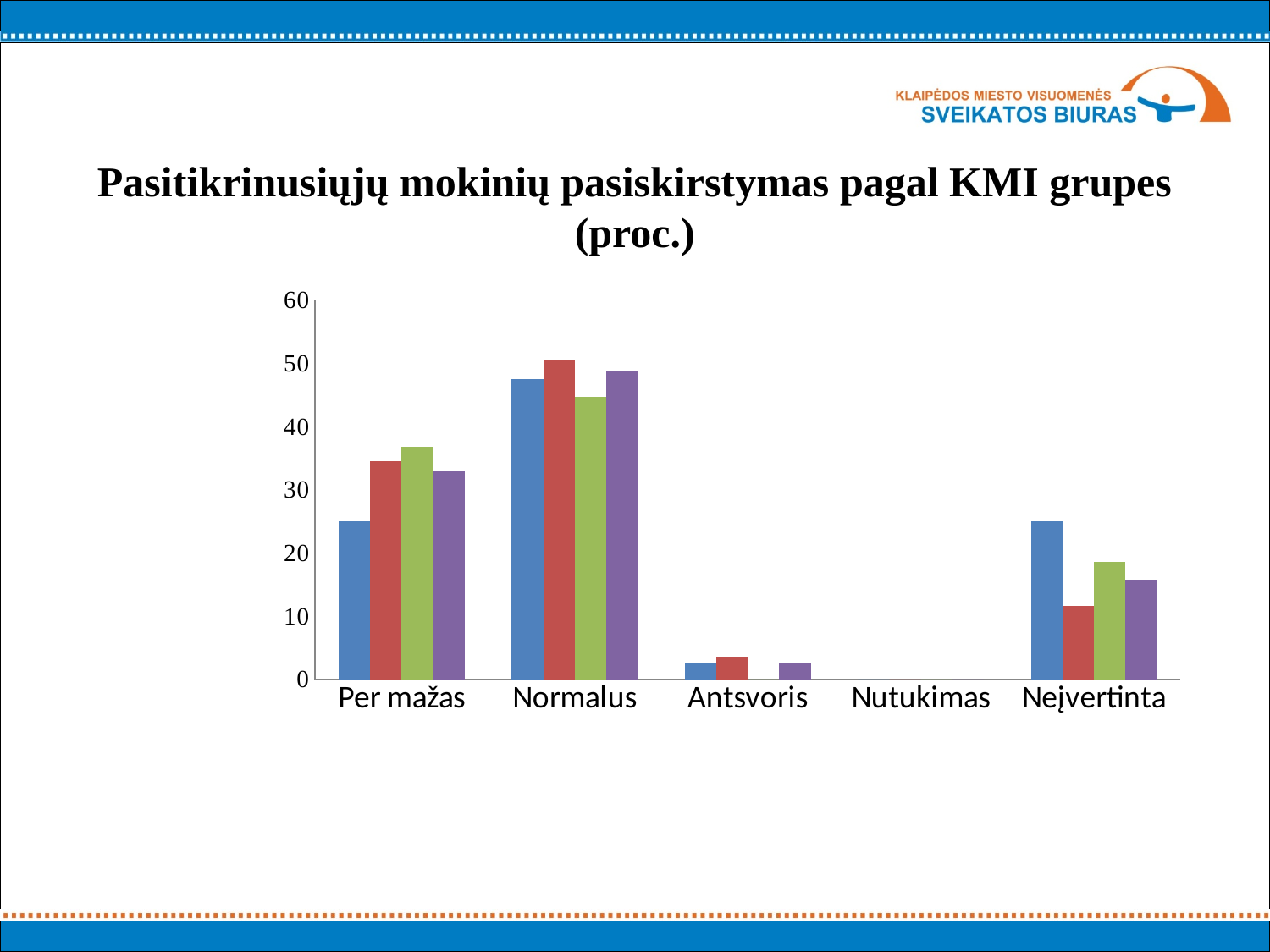
For Normalus, which is larger: the red bar or the green bar? the red bar What is the title of the chart on the slide? Pasitikrinusiųjų mokinių pasiskirstymas pagal KMI grupes (proc.) Is the blue bar for Per mažas greater or less than 20? greater Is the green bar for Per mažas greater or less than 40? less Is the blue bar for Normalus greater or less than 50? less Which category has the tallest bars in the chart? Normalus For Per mažas, which is larger: the blue bar or the green bar? the green bar For Neįvertinta, which is larger: the blue bar or the red bar? the blue bar What kind of chart is shown on the slide? bar chart How many categories are shown on the x axis of the chart? 5